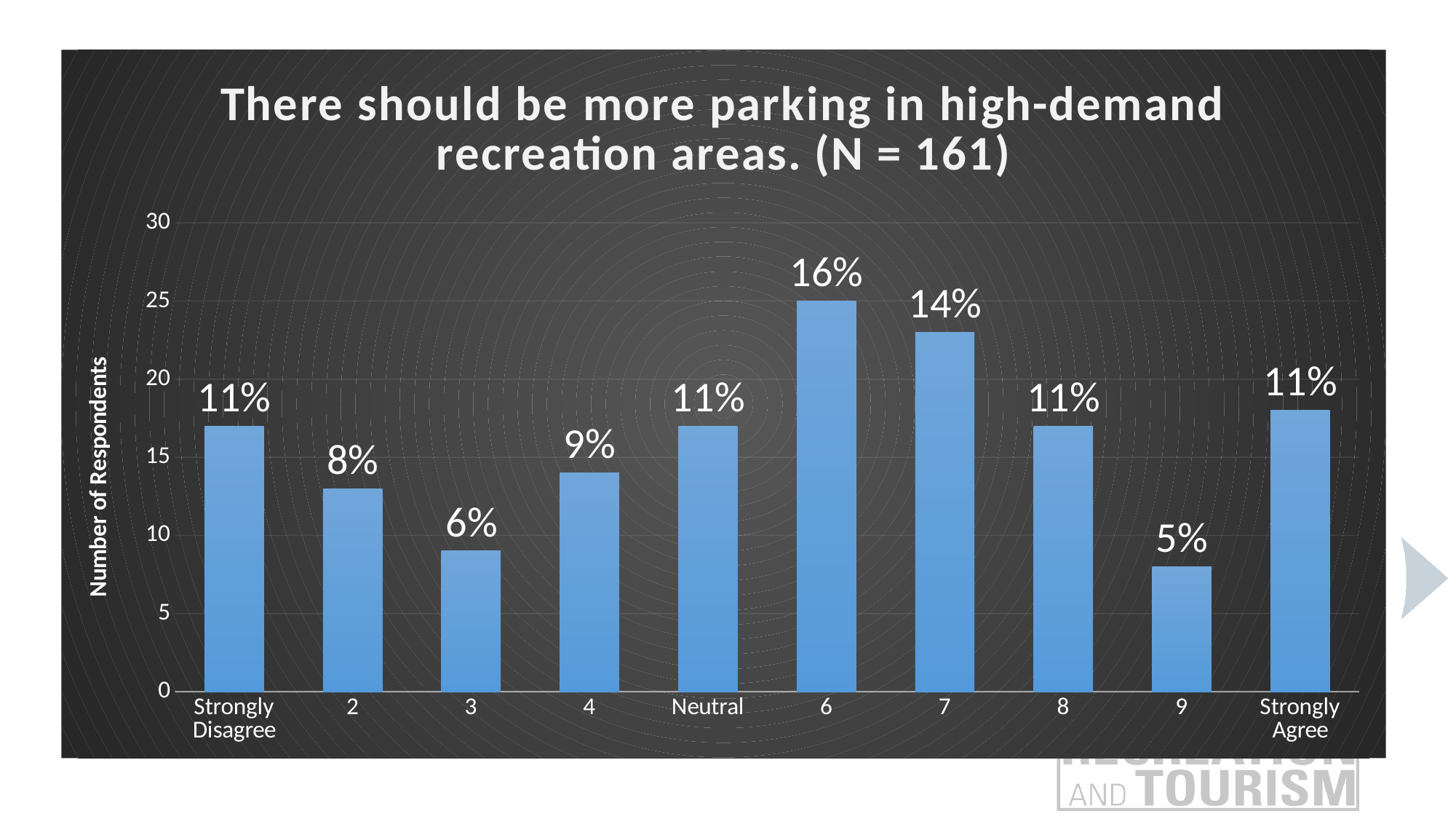
Is the number of respondents for category 9 greater or less than 10? less Which bar is taller, category 7 or category 4? 7 Is the number of respondents for category 6 greater or less than 20? greater Which category has the highest bar? 6 What is the difference between the percentage labels for category 6 and category 3? 10% How many categories are shown on the x axis? 10 What is the data label shown on the bar for category 6? 16% What is the data label shown on the bar for Strongly Agree? 11% Which category has the lowest bar? 9 What is the title of the vertical axis? Number of Respondents What kind of chart is shown on the slide? bar chart What is the data label shown on the bar for category 3? 6%